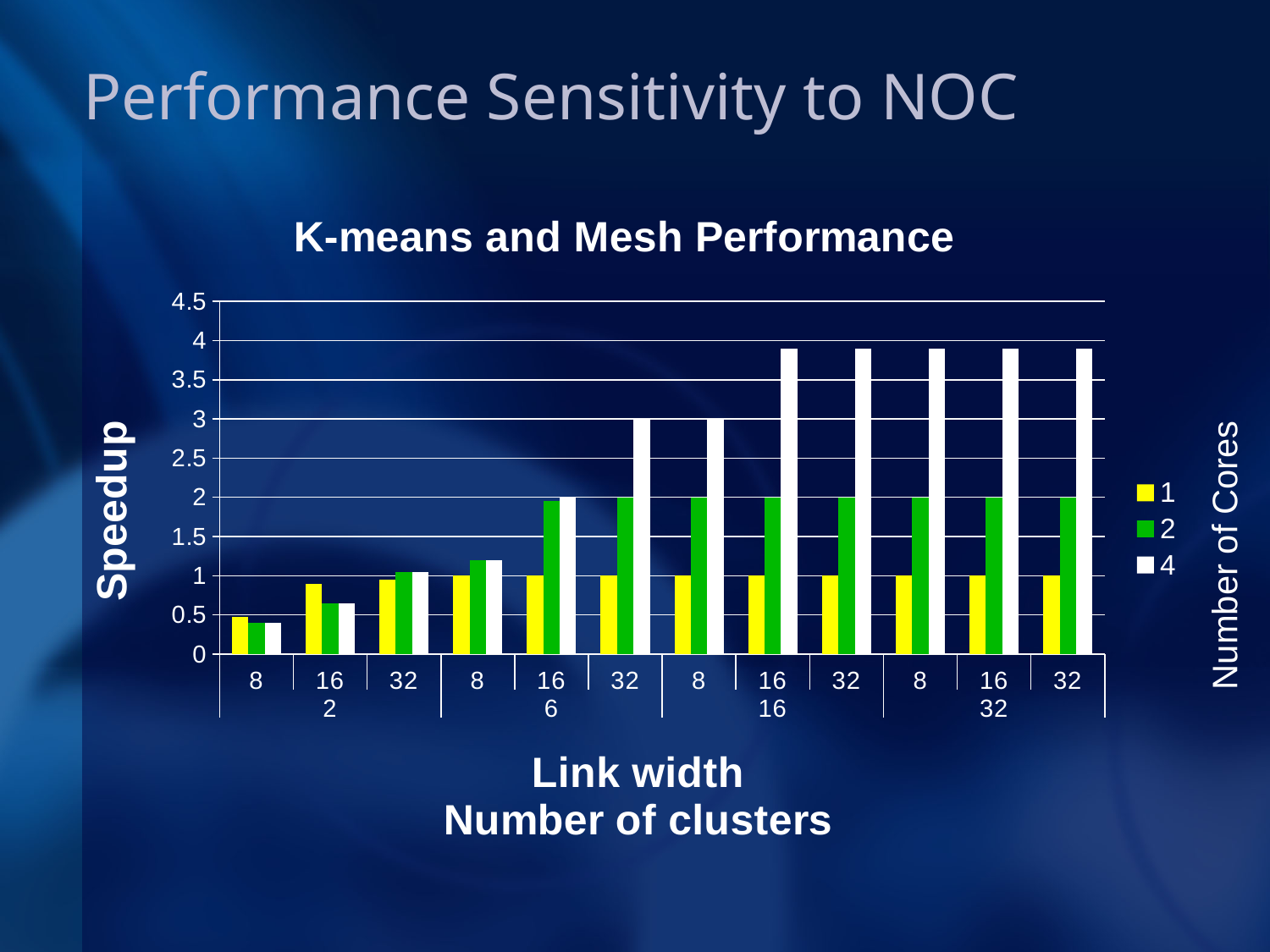
Is the speedup for 4 cores at 32 clusters and link width 32 greater or less than 3.5? greater For 4 cores at 6 clusters, does the speedup rise or fall as link width increases from 8 to 32? rise Is the speedup for 2 cores at 16 clusters and link width 8 greater or less than 1.5? greater Which number of cores reaches the highest speedup anywhere in the chart? 4 How many link-width groups (bar groups) are plotted along the x axis? 12 What is the title of the legend? Number of Cores What kind of chart is shown on the slide? bar chart What is the label on the vertical axis? Speedup How many series does the legend list? 3 At 16 clusters and link width 16, which has the larger speedup: 1 core or 4 cores? 4 cores Is the speedup for 4 cores at 6 clusters and link width 32 greater or less than 2.5? greater